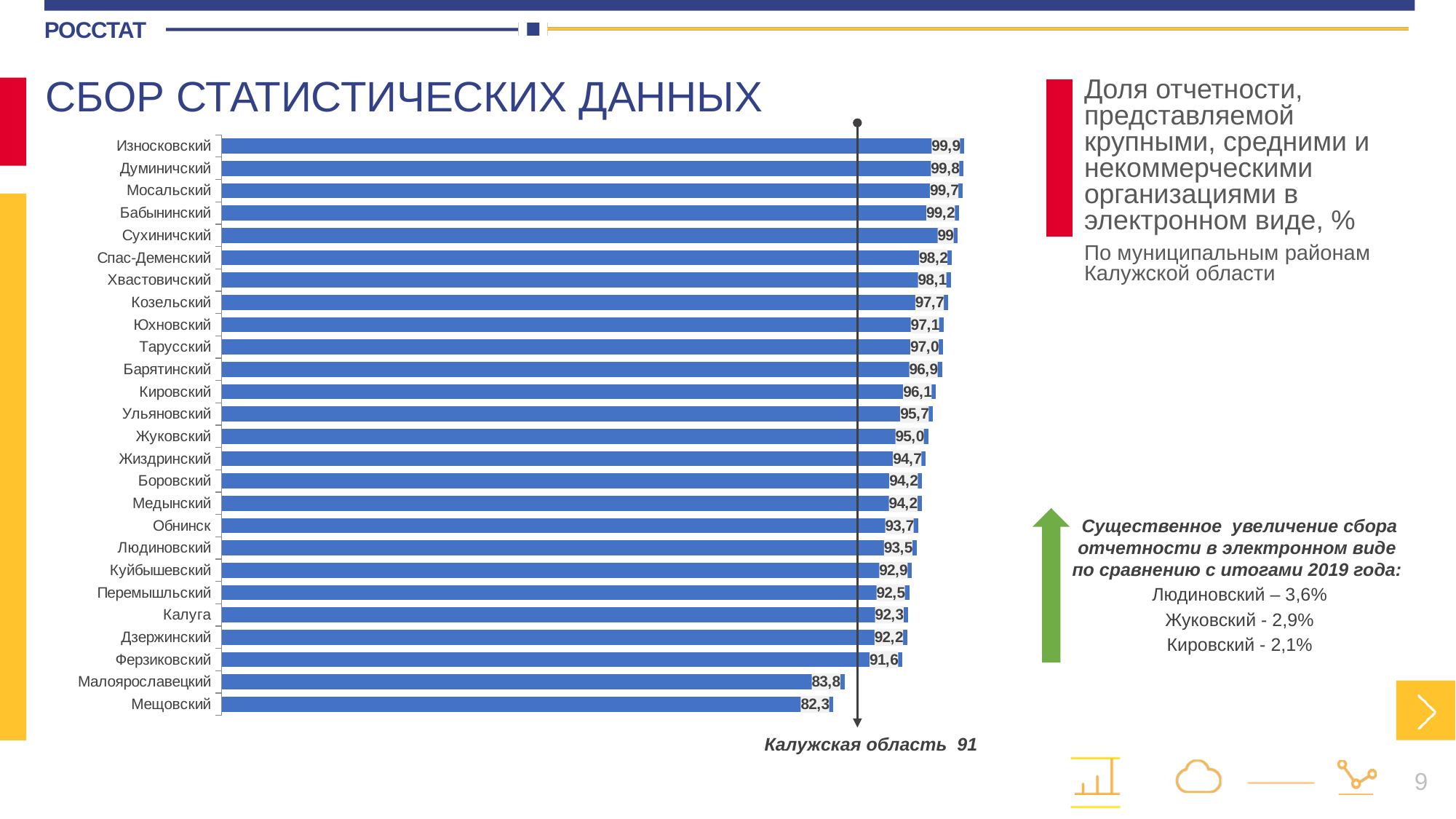
What is the value for Кировский? 96,1 What is the value for Ферзиковский? 91,6 What is the difference between the values for Износковский and Мещовский? 17,6 Which district has the highest value? Износковский Which has a larger value, Сухиничский or Козельский? Сухиничский What is the value for Обнинск? 93,7 How many districts are shown in the chart? 26 What value is given for Калужская область as a whole on the chart? 91 Which district has the lowest value? Мещовский What type of chart is shown on the slide? bar chart What is the value for Калуга? 92,3 What is the difference between the values for Малоярославецкий and Мещовский? 1,5